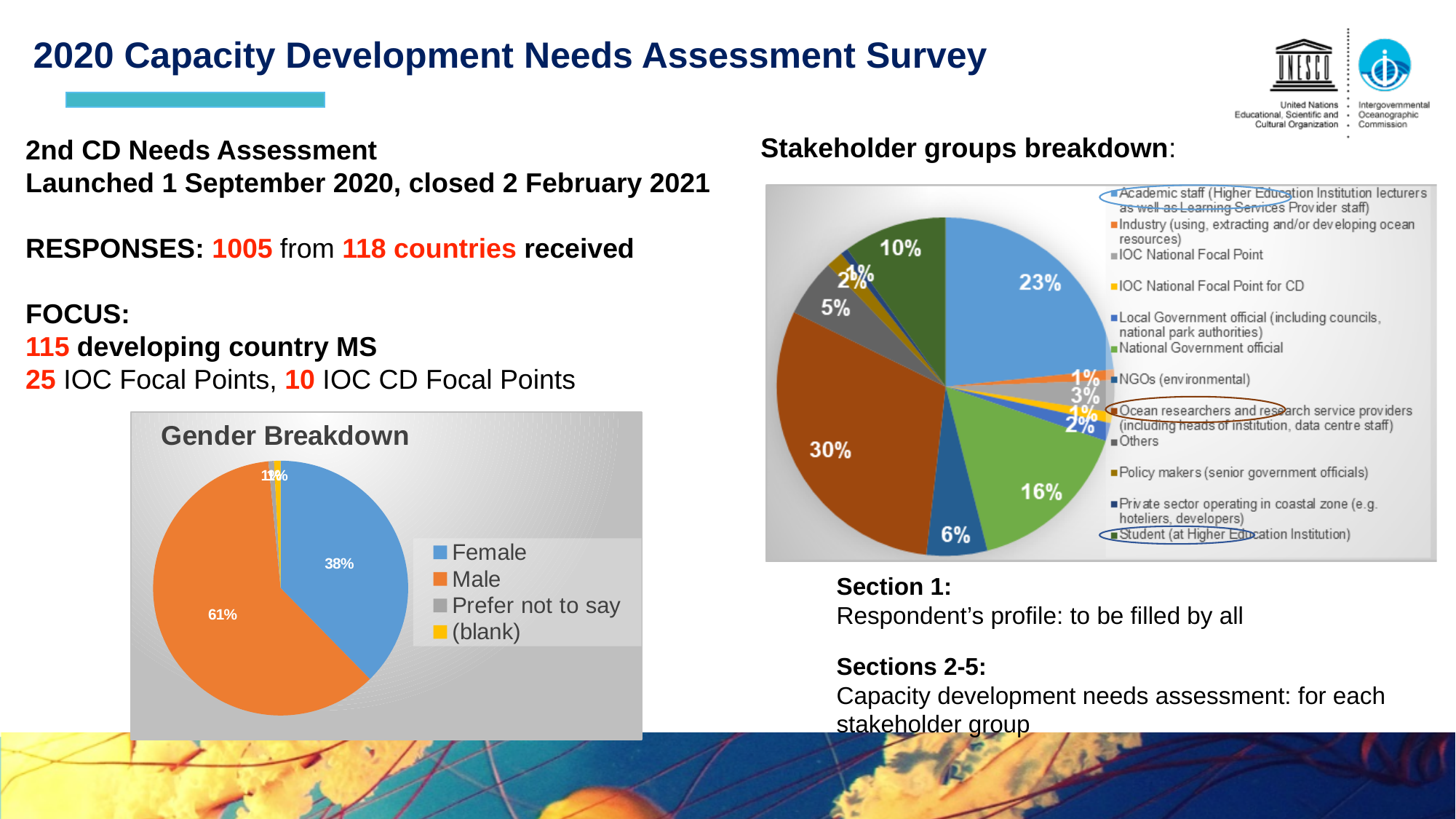
In the Stakeholder groups breakdown chart, which is larger: the share of Academic staff or the share of National Government officials? Academic staff In the Stakeholder groups breakdown chart, what share do Students (at Higher Education Institution) have? 10% In the Stakeholder groups breakdown chart, which stakeholder group has the largest share? Ocean researchers and research service providers In the Stakeholder groups breakdown chart, what share do Academic staff have? 23% How many categories does the legend of the Gender Breakdown chart list? 4 In the Gender Breakdown chart, which category has the largest share? Male In the Stakeholder groups breakdown chart, what share do Ocean researchers and research service providers have? 30% In the Stakeholder groups breakdown chart, what share do National Government officials have? 16% In the Gender Breakdown chart, what percentage of respondents are Female? 38% In the Gender Breakdown chart, what is the difference between the Male and Female shares? 23% What type of chart is the Gender Breakdown chart? Pie chart In the Gender Breakdown chart, what percentage of respondents are Male? 61%